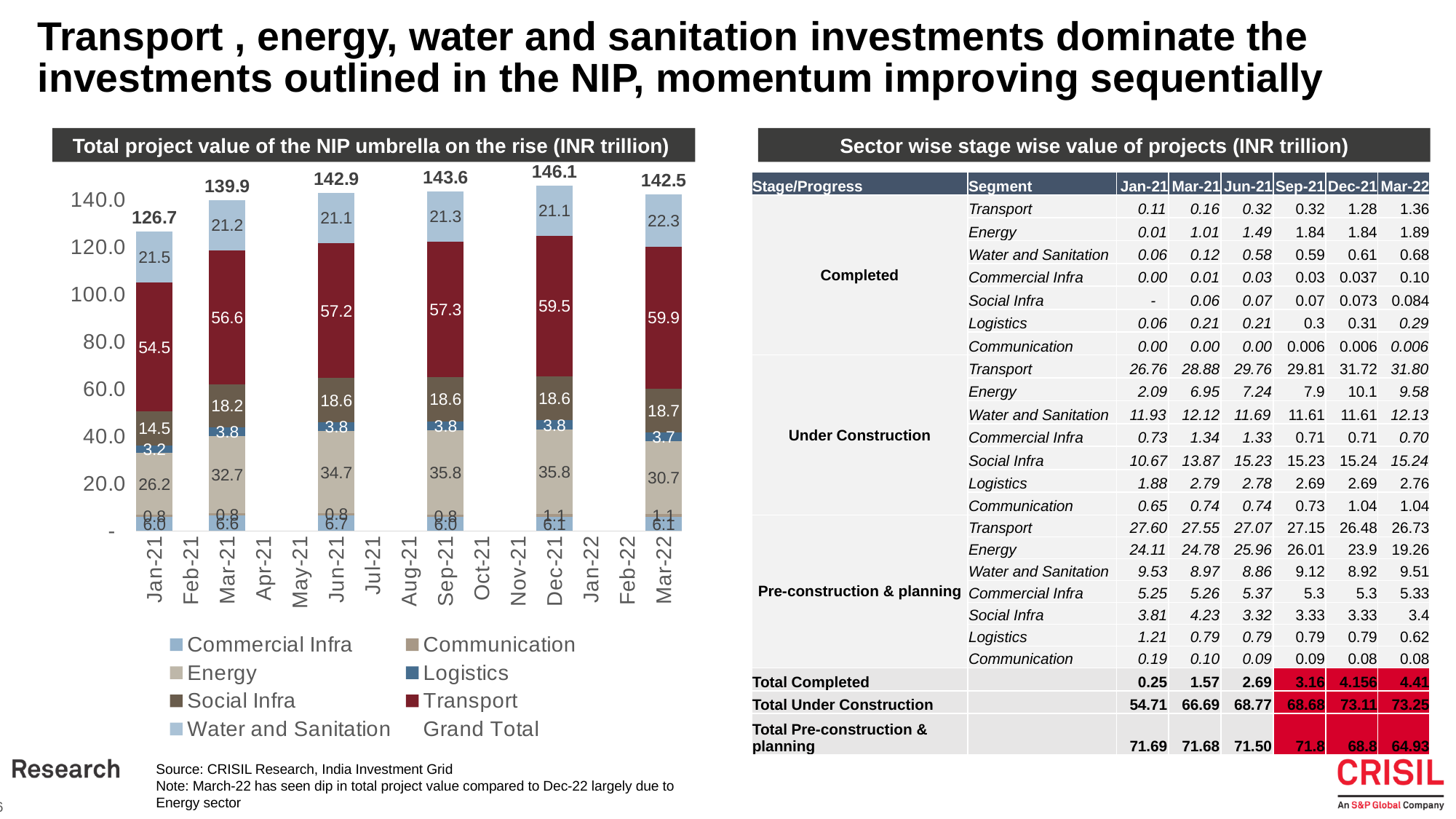
What is the Transport value in the Mar-22 bar? 59.9 Is the Grand Total for Jan-21 greater or less than 140.0? less Which period has the highest Grand Total? Dec-21 What is the Water and Sanitation value in the Jan-21 bar? 21.5 What is the Grand Total value shown above the Dec-21 bar? 146.1 What type of chart is used to show the total project value of the NIP umbrella? Stacked bar chart Is the Transport value larger in Jun-21 or in Dec-21? Dec-21 What is the Energy value in the Sep-21 bar? 35.8 How many stacked bars are plotted in the chart? 6 How many entries does the chart legend list? 8 Which period has the lowest Grand Total? Jan-21 What is the difference between the Grand Total for Dec-21 and Mar-22? 3.6